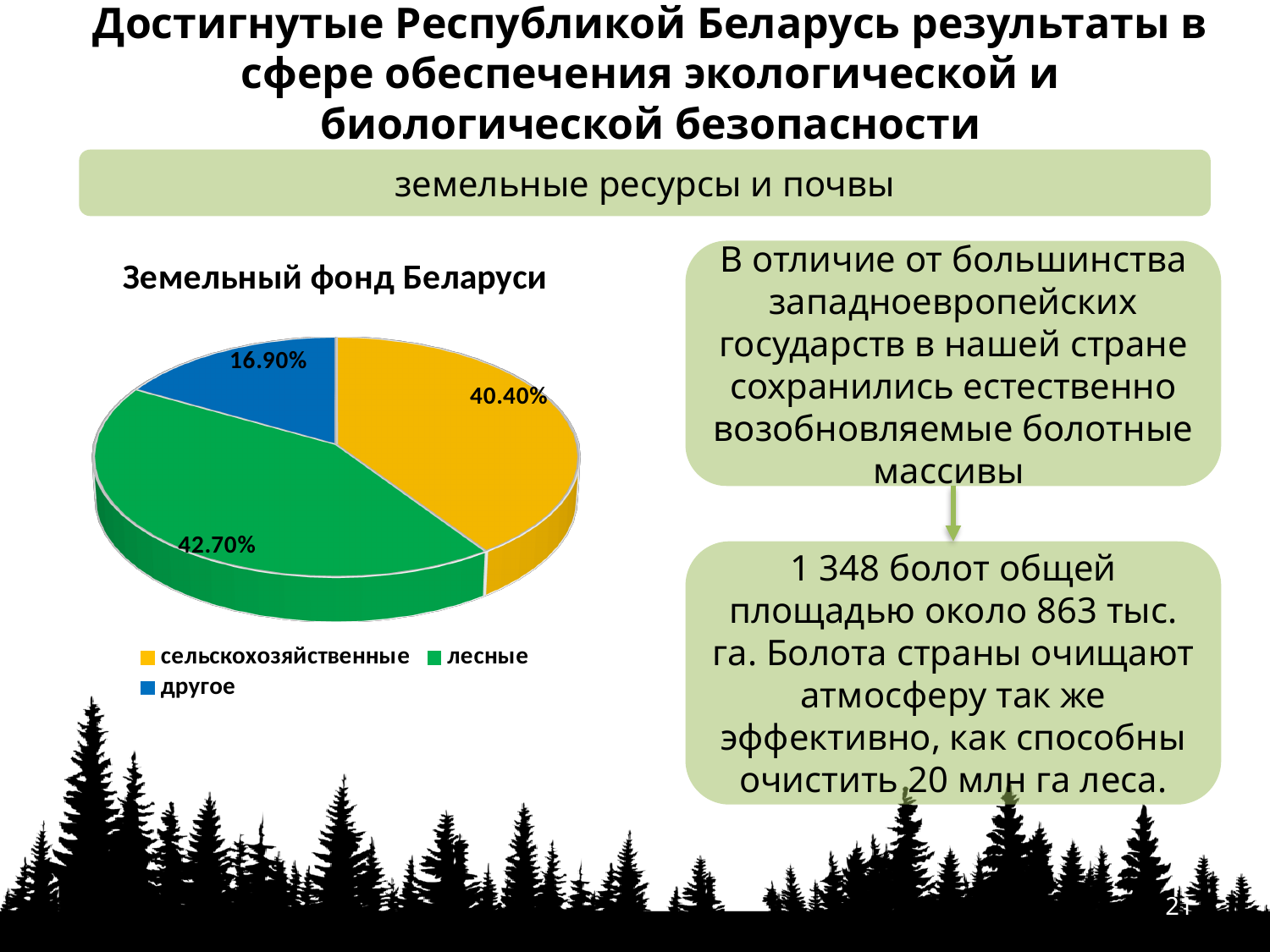
Which category has the largest share in the pie chart? лесные What is the value for "другое" in the pie chart? 16.90% What is the title of the pie chart? Земельный фонд Беларуси What is the difference between the shares of "сельскохозяйственные" and "другое"? 23.50% Which category has the smallest share in the pie chart? другое How many slices does the pie chart have? 3 What is the value for "лесные" in the pie chart? 42.70% What is the difference between the shares of "лесные" and "сельскохозяйственные"? 2.30% What is the value for "сельскохозяйственные" in the pie chart? 40.40% What type of chart is shown under the title "Земельный фонд Беларуси"? pie chart Which colour represents "другое" in the pie chart? blue Which is larger in the pie chart: "сельскохозяйственные" or "другое"? сельскохозяйственные